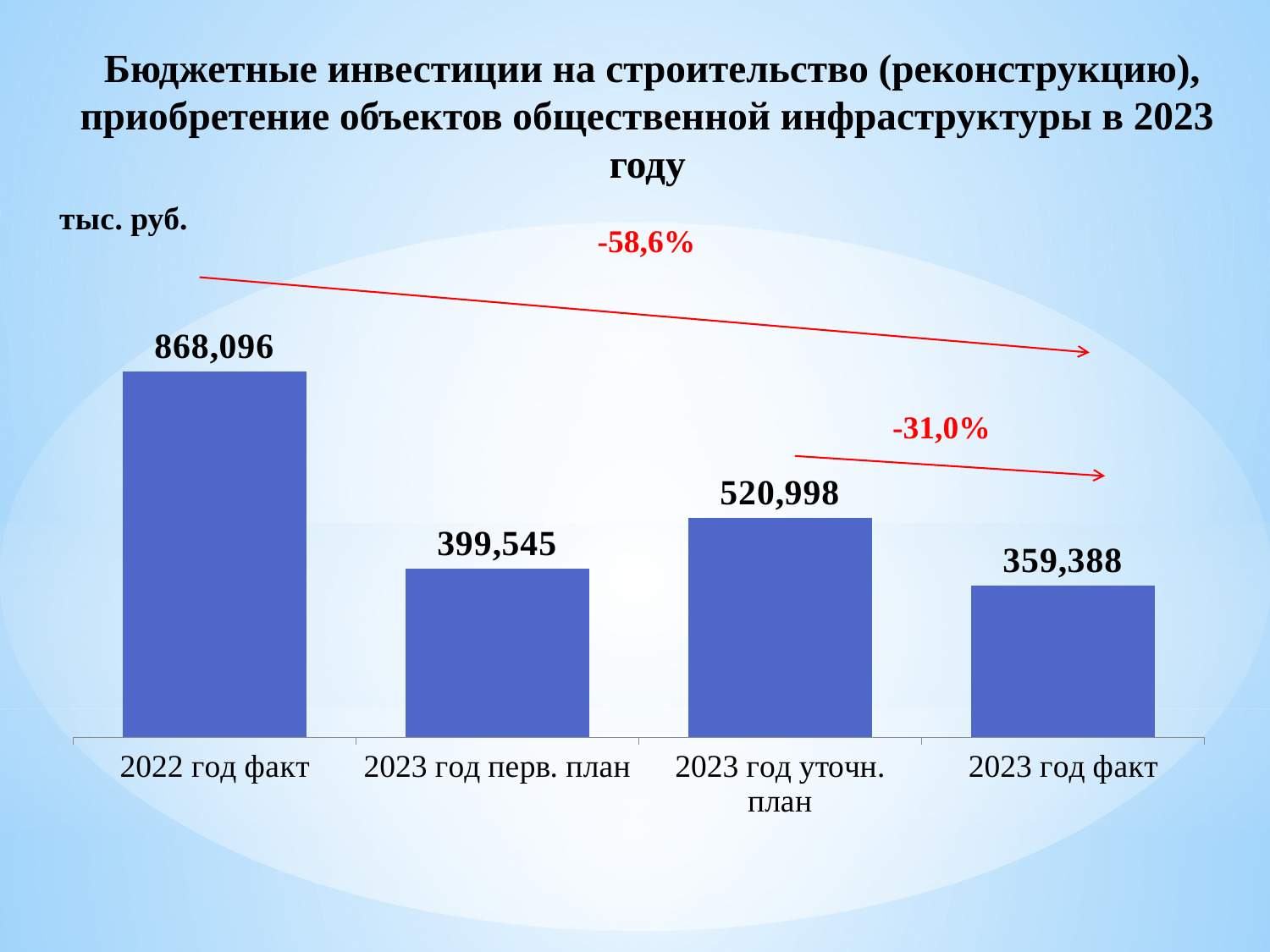
Which is larger, the value for 2023 год уточн. план or the value for 2023 год перв. план? 2023 год уточн. план Which category has the highest value? 2022 год факт What is the value for 2023 год перв. план? 399,545 Which category has the lowest value? 2023 год факт What is the value for 2023 год факт? 359,388 What is the difference between the values for 2023 год уточн. план and 2023 год перв. план? 121,453 What is the value for 2022 год факт? 868,096 What kind of chart is shown on the slide? bar chart How many categories are shown in the chart? 4 What is the difference between the values for 2022 год факт and 2023 год факт? 508,708 What is the value for 2023 год уточн. план? 520,998 What percentage change is shown by the red arrow from 2022 год факт to 2023 год факт? -58,6%